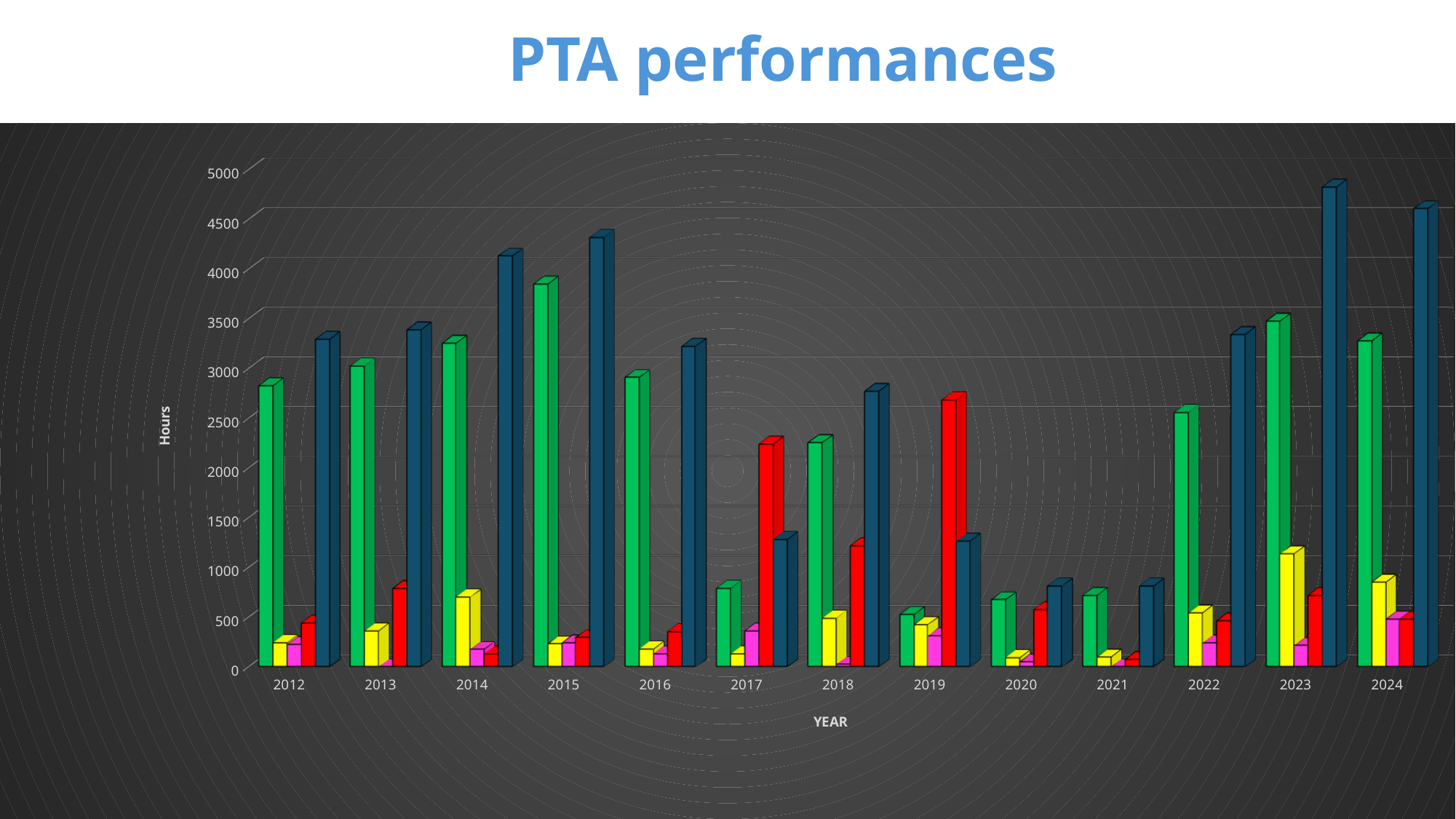
How many years are shown on the x axis of the chart? 13 Is the green bar for 2017 greater or less than 1000? less Which is larger in 2018, the green bar or the red bar? The green bar In which year is the dark blue bar the highest? 2023 In which year is the red bar the highest? 2019 Do the dark blue bars rise or fall from 2012 to 2015? Rise In which year is the green bar the highest? 2015 What is the title of the chart slide? PTA performances What kind of chart is shown on the slide? Bar chart What is the label of the vertical axis? Hours How many bars are shown for each year in the chart? 5 Is the dark blue bar for 2023 greater or less than 4500? greater